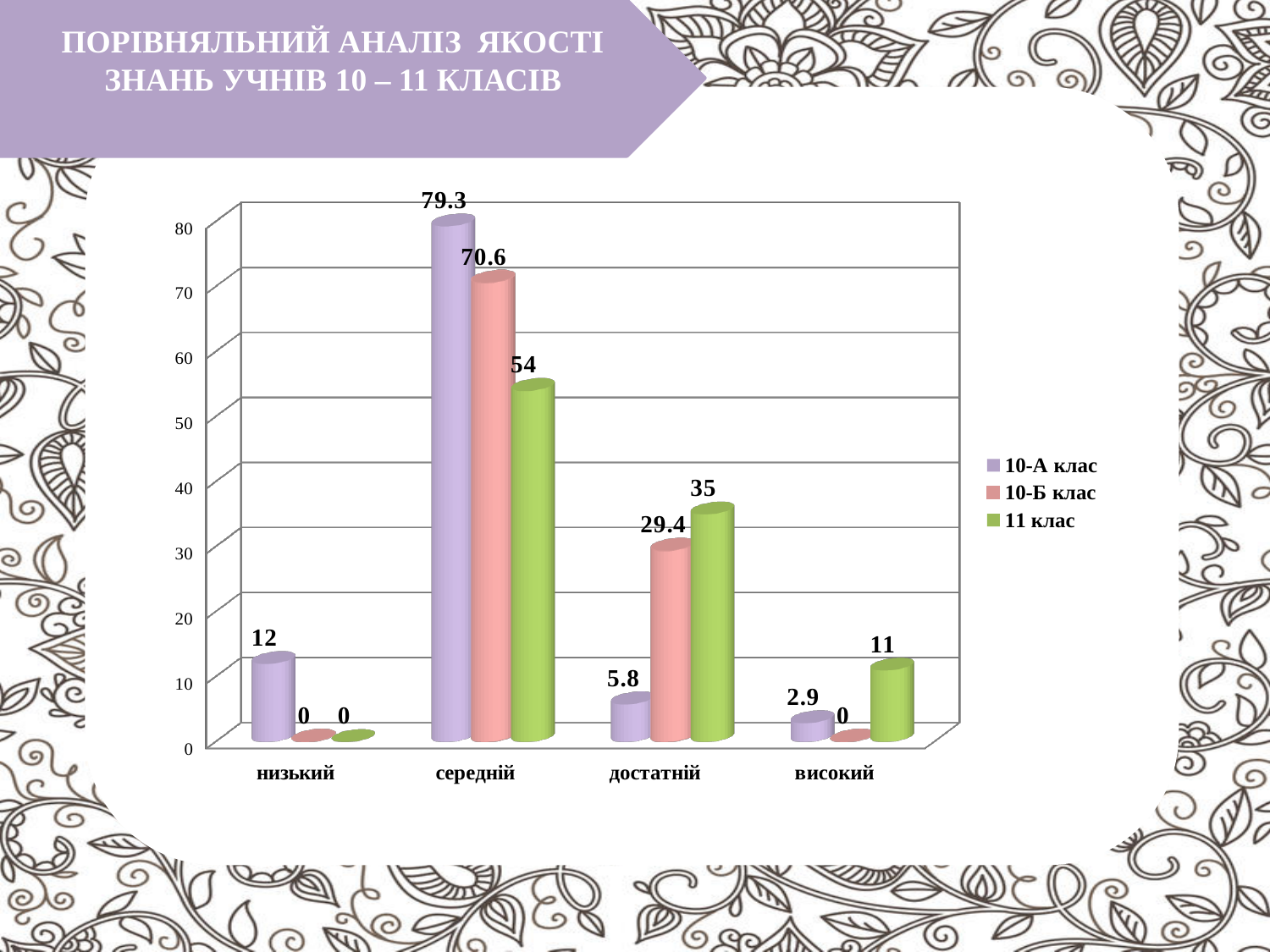
How many series does the legend list? 3 Which series is shown in green in the legend? 11 клас What is the value for 10-А клас in the середній category? 79.3 What is the difference between the 10-А клас and 10-Б клас values in the середній category? 8.7 Which category has the highest value for 10-Б клас? середній What is the difference between the 11 клас values in the середній and достатній categories? 19 What is the value for 10-Б клас in the високий category? 0 What kind of chart is shown on the slide? bar chart In the достатній category, which is larger: the value for 10-Б клас or for 11 клас? 11 клас How many categories are shown on the x axis? 4 Which category has the lowest value for 10-А клас? високий What is the value for 11 клас in the достатній category? 35